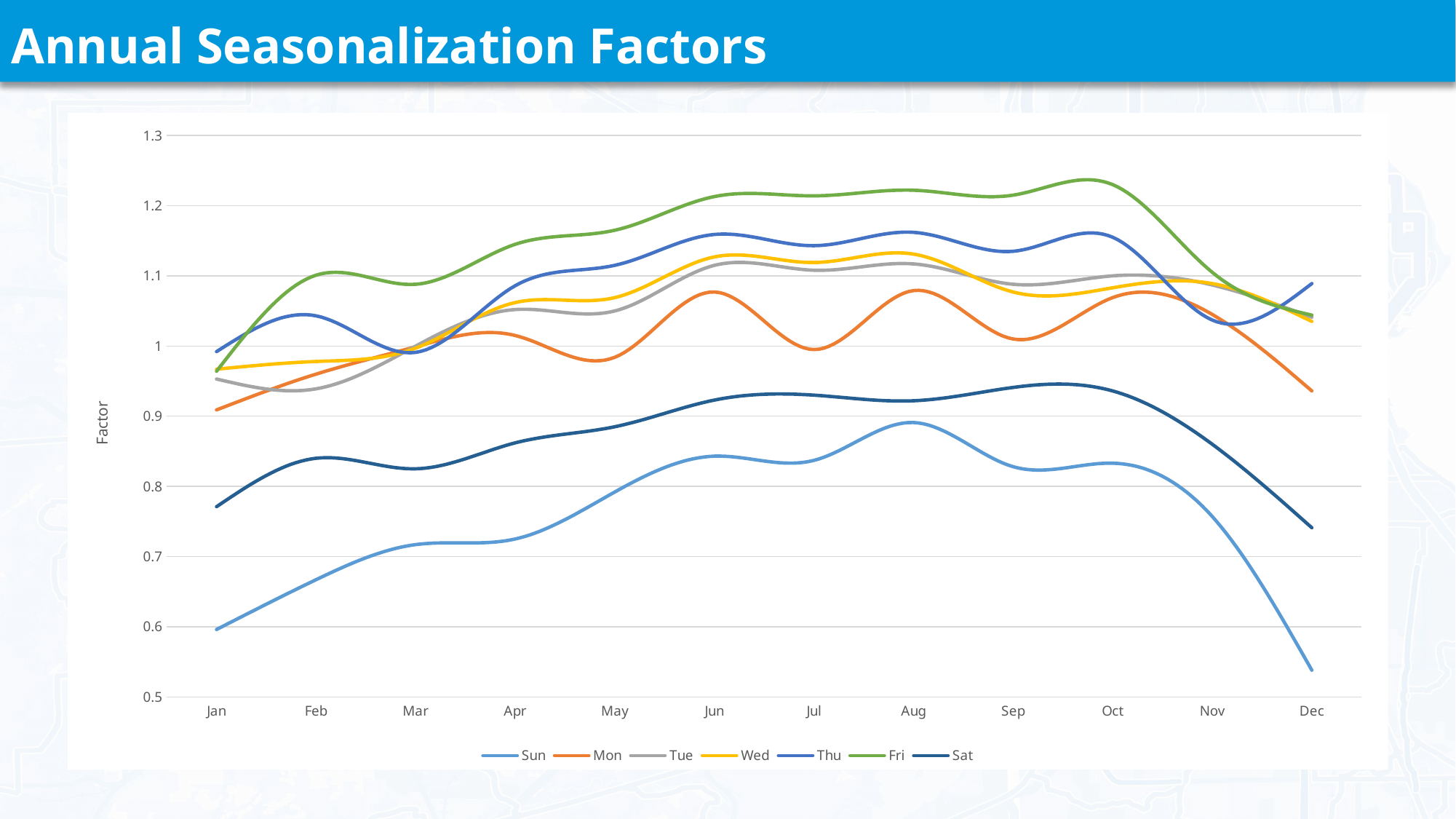
How many series does the legend list? 7 In Jan, which is higher, Sat or Sun? Sat Is the value for Sat in Dec greater or less than 0.8? less How many months are plotted along the x axis? 12 Which series has the lowest value in Dec? Sun Is the value for Sun in Jan greater or less than 0.7? less Is the value for Fri in Oct greater or less than 1.2? greater Which series has the highest value in Oct? Fri Does the Sun series rise or fall from Jan to Aug? rise What is the label on the vertical axis? Factor What kind of chart is shown on the slide? line chart What is the title of the slide? Annual Seasonalization Factors